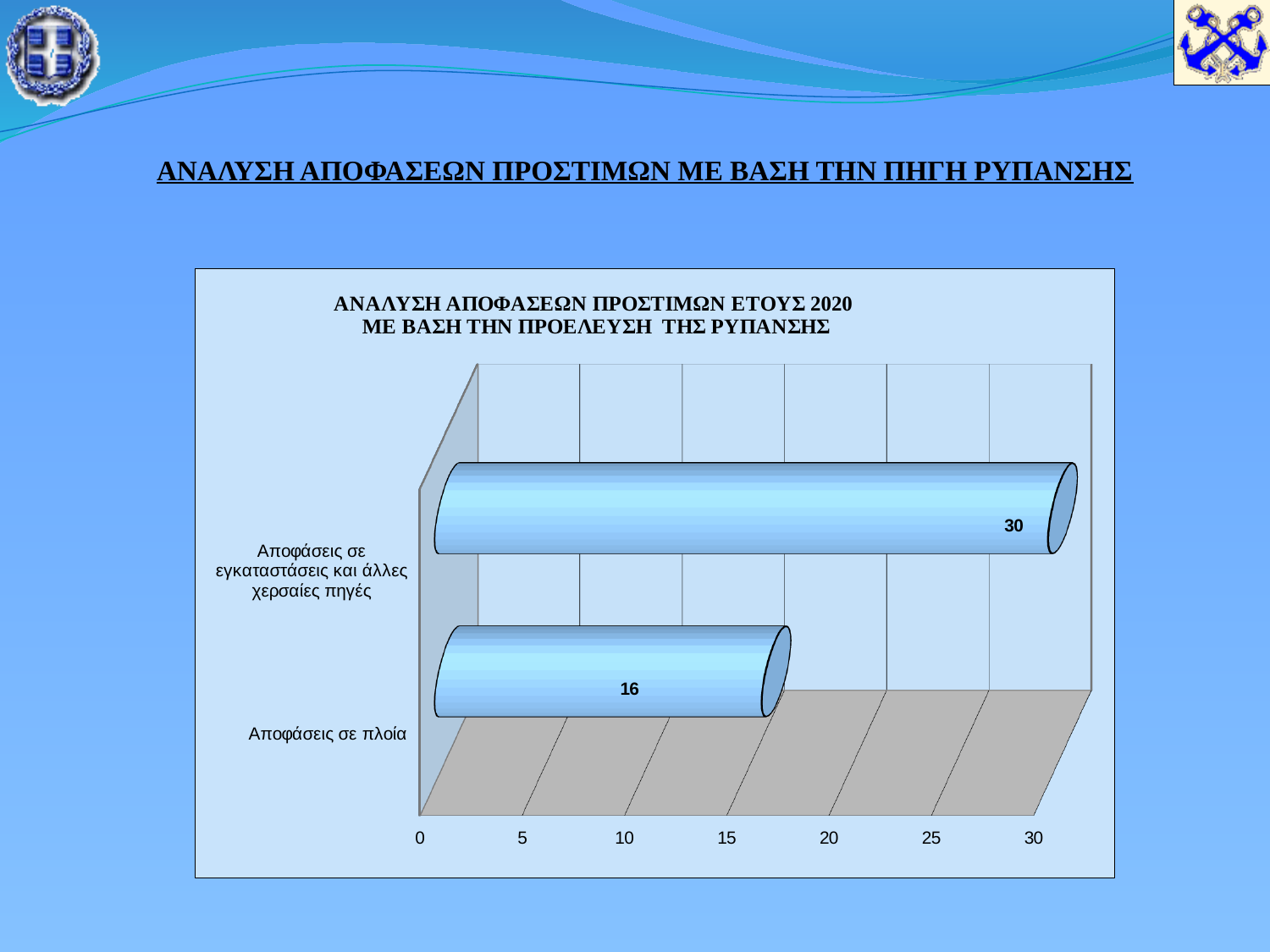
What is the difference between the value for 'Αποφάσεις σε εγκαταστάσεις και άλλες χερσαίες πηγές' and the value for 'Αποφάσεις σε πλοία'? 14 What is the value for 'Αποφάσεις σε πλοία'? 16 Which category has the highest value? Αποφάσεις σε εγκαταστάσεις και άλλες χερσαίες πηγές Which year does the chart title refer to? 2020 What is the value for 'Αποφάσεις σε εγκαταστάσεις και άλλες χερσαίες πηγές'? 30 Is the value for 'Αποφάσεις σε πλοία' greater or less than 20? less Which is larger: the value for 'Αποφάσεις σε πλοία' or the value for 'Αποφάσεις σε εγκαταστάσεις και άλλες χερσαίες πηγές'? Αποφάσεις σε εγκαταστάσεις και άλλες χερσαίες πηγές What kind of chart is shown on the slide? Bar chart Which category has the lowest value? Αποφάσεις σε πλοία How many categories are shown in the chart? 2 What is the total of the two values shown in the chart? 46 Is the value for 'Αποφάσεις σε εγκαταστάσεις και άλλες χερσαίες πηγές' greater or less than 25? greater